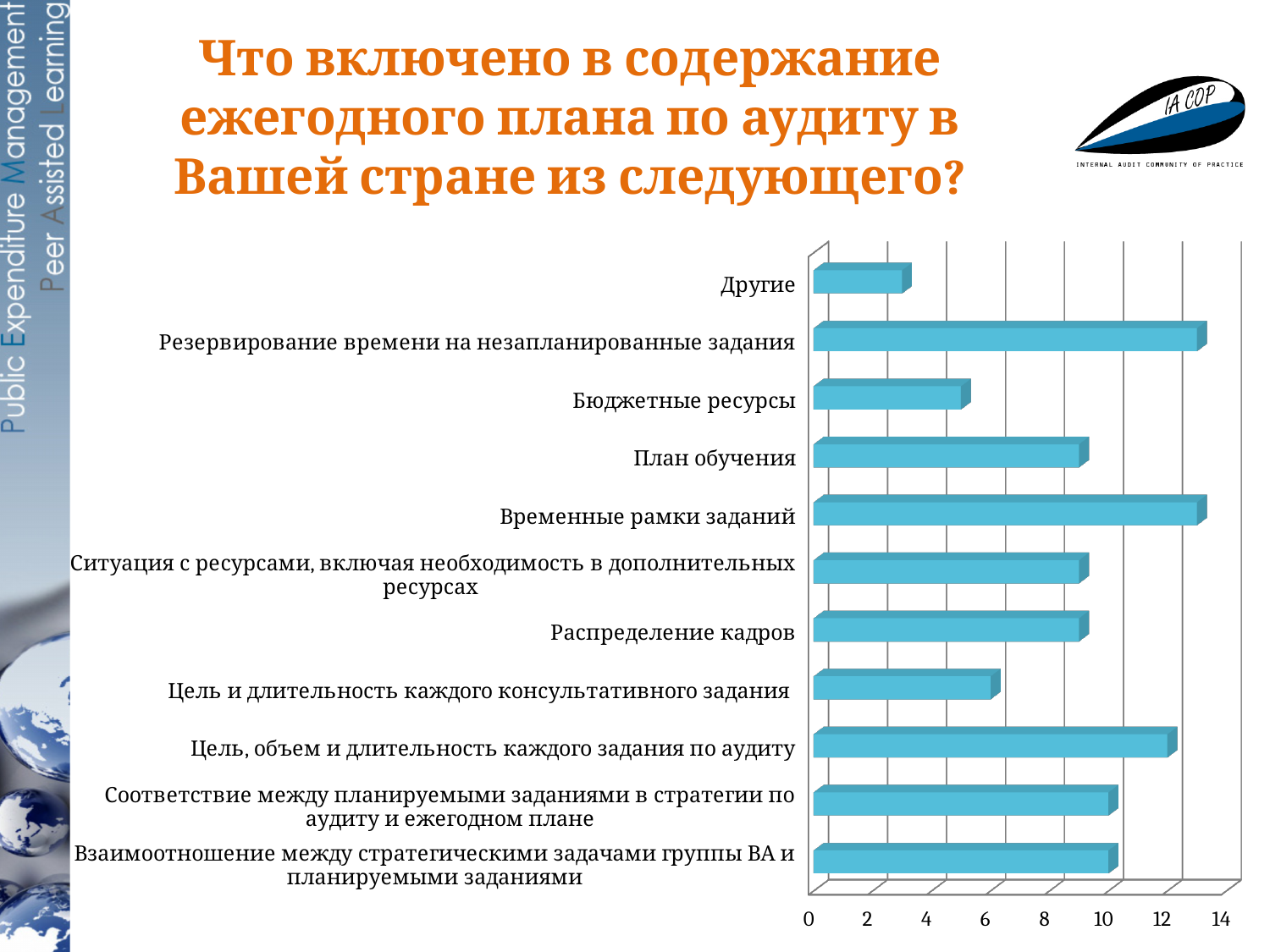
Is the value for Цель, объем и длительность каждого задания по аудиту greater or less than 10? greater Which is larger, the value for Бюджетные ресурсы or the value for План обучения? План обучения Is the value for План обучения greater or less than 8? greater Which category has the lowest value in the chart? Другие Is the value for Цель и длительность каждого консультативного задания greater or less than 8? less Which is larger, the value for Цель и длительность каждого консультативного задания or the value for Цель, объем и длительность каждого задания по аудиту? Цель, объем и длительность каждого задания по аудиту What kind of chart is shown on the slide? bar chart What is the highest value shown on the horizontal axis of the chart? 14 How many categories are plotted in the chart? 11